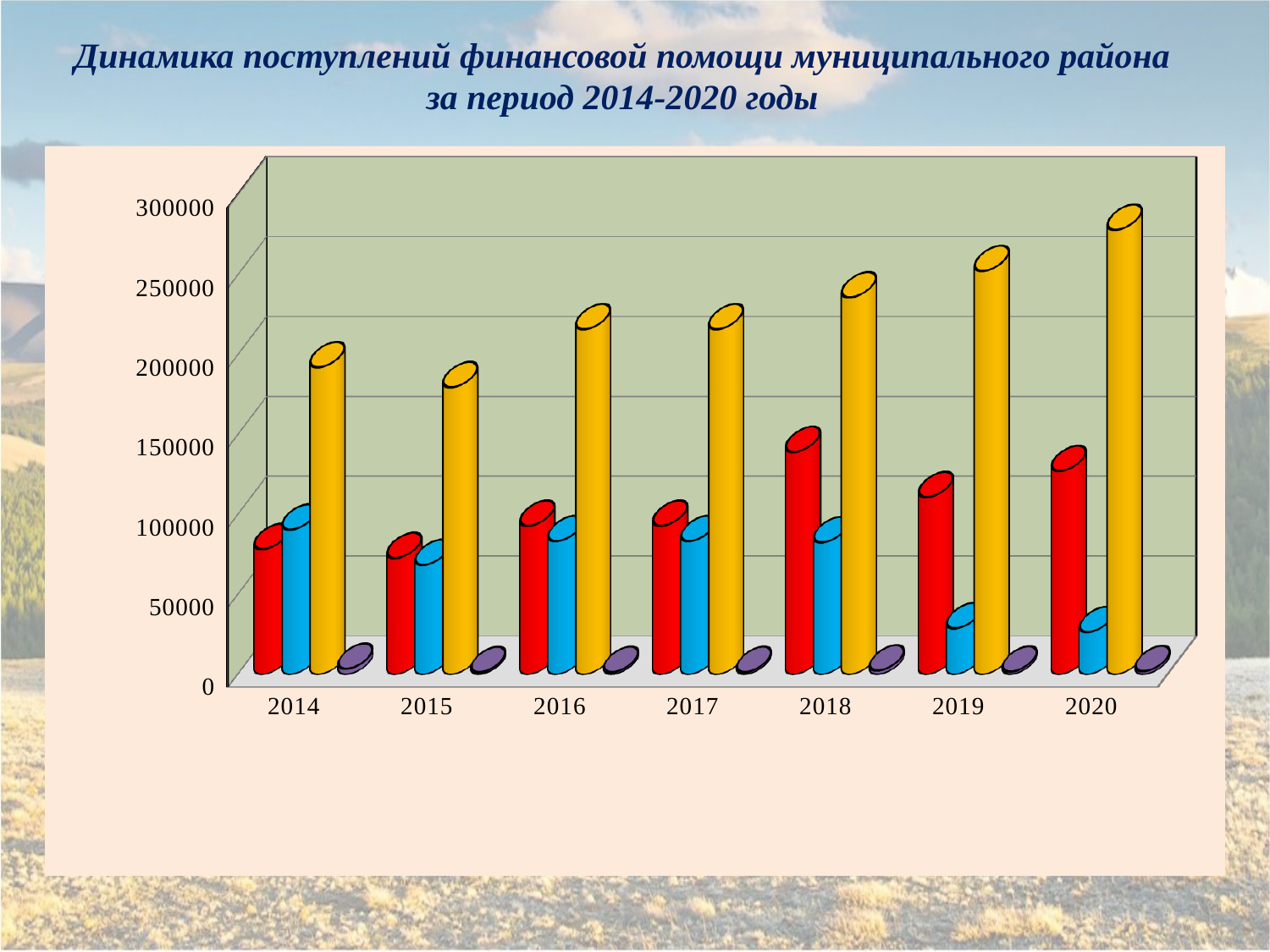
What kind of chart is shown on the slide? Bar chart In which year is the yellow bar the tallest? 2020 How many years are shown along the x axis of the chart? 7 Which year has the larger blue bar, 2014 or 2020? 2014 Is the red bar for 2018 greater or less than 100000? greater Is the yellow bar for 2015 greater or less than 200000? less In which year is the yellow bar the shortest? 2015 Is the blue bar for 2019 greater or less than 50000? less What is the title of the slide's chart? Динамика поступлений финансовой помощи муниципального района за период 2014-2020 годы Which year has the larger red bar, 2015 or 2018? 2018 How many bars are plotted for each year in the chart? 4